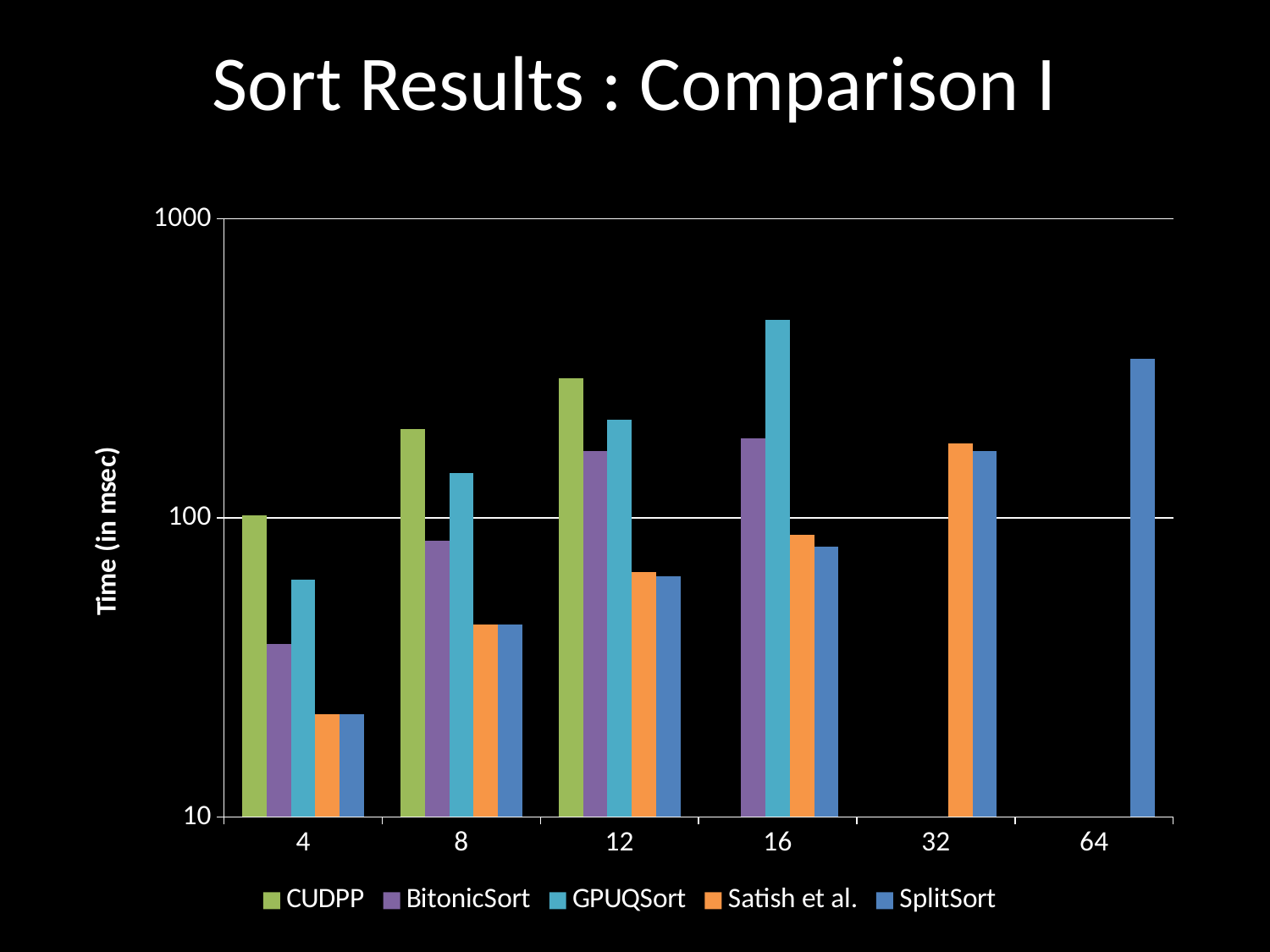
What kind of chart is shown on the slide? bar chart Is the value for GPUQSort at category 16 greater or less than 100? greater How many categories are shown on the x axis? 6 How many series does the legend list? 5 Is the value for SplitSort at category 64 greater or less than 100? greater Which series has the highest value at category 12? CUDPP Which series has the highest value at category 16? GPUQSort What is the title of the chart? Sort Results : Comparison I Is the value for Satish et al. at category 4 greater or less than 100? less At category 8, which is larger: the value for CUDPP or the value for GPUQSort? CUDPP Do the values for GPUQSort rise or fall from category 4 to category 16? rise What is the label of the y axis? Time (in msec)